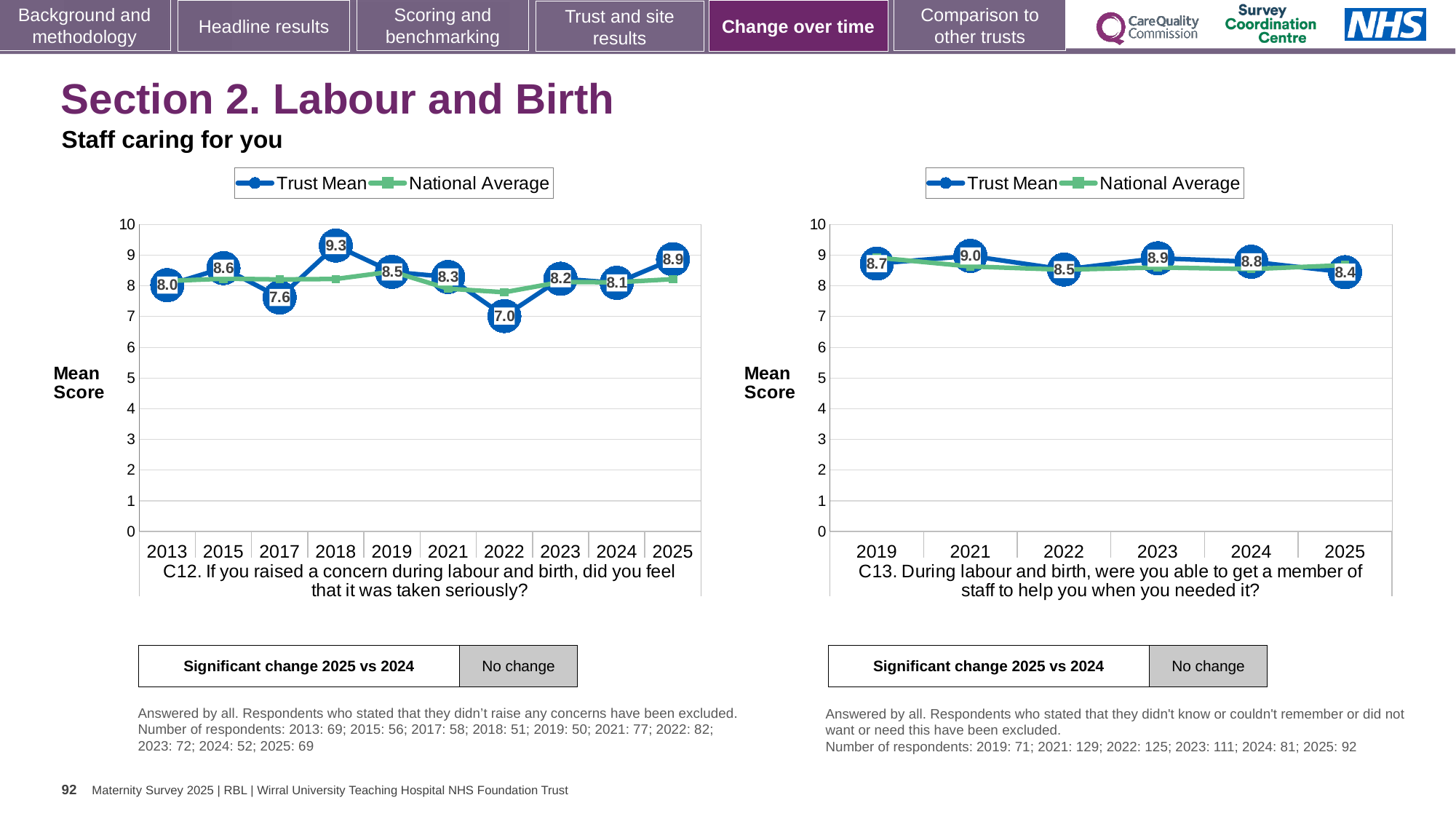
In the C13 chart on the right, what is the Trust Mean score for 2021? 9.0 In the C12 chart on the left, which year has the lowest Trust Mean score? 2022 In the C13 chart on the right, which year has the lowest Trust Mean score? 2025 In the C12 chart on the left, what is the Trust Mean score for 2022? 7.0 In the C12 chart on the left, is the Trust Mean score for 2022 greater or less than 8? less In the C13 chart on the right, how many series does the legend list? 2 In the C12 chart on the left, which year has the highest Trust Mean score? 2018 In the C13 chart on the right, is the Trust Mean score for 2023 or 2025 higher? 2023 In the C12 chart on the left, what is the difference between the Trust Mean scores for 2025 and 2024? 0.8 In the C12 chart on the left, how many years are plotted on the x axis? 10 What type of chart is the C13 chart on the right? Line chart In the C12 chart on the left, what is the Trust Mean score for 2018? 9.3